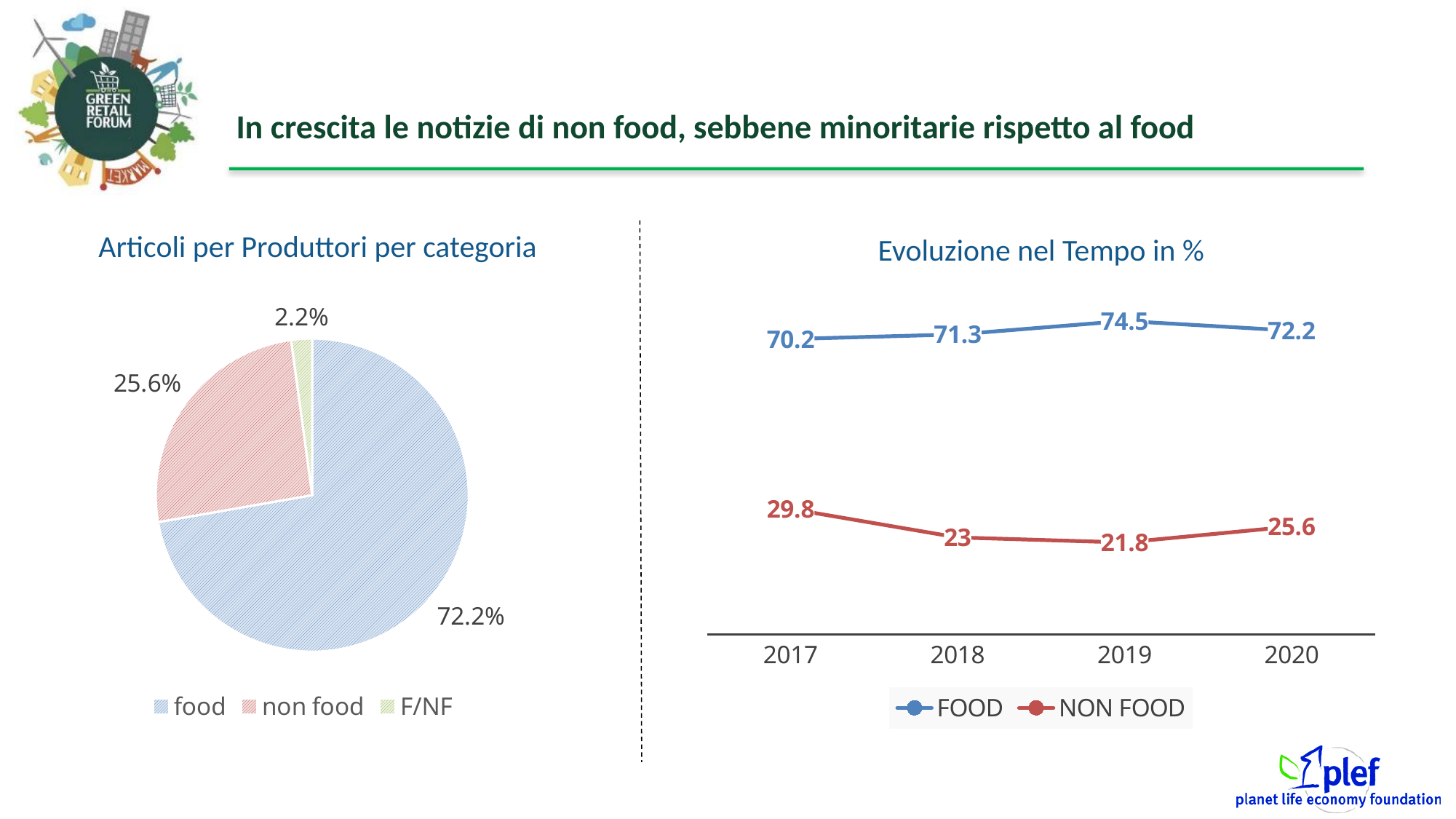
In the pie chart 'Articoli per Produttori per categoria', what share does 'non food' have? 25.6% In the chart 'Evoluzione nel Tempo in %', does the NON FOOD value rise or fall from 2017 to 2018? fall In the pie chart 'Articoli per Produttori per categoria', what share does 'F/NF' have? 2.2% In the chart 'Evoluzione nel Tempo in %', in which year is the NON FOOD value lowest? 2019 What kind of chart is 'Evoluzione nel Tempo in %'? line chart In the chart 'Evoluzione nel Tempo in %', what is the difference between the FOOD and NON FOOD values in 2020? 46.6 How many series does the legend of the chart 'Evoluzione nel Tempo in %' list? 2 How many categories does the pie chart 'Articoli per Produttori per categoria' show? 3 In the chart 'Evoluzione nel Tempo in %', what is the NON FOOD value for 2017? 29.8 In the pie chart 'Articoli per Produttori per categoria', which category has the smallest slice? F/NF In the pie chart 'Articoli per Produttori per categoria', which category has the largest slice? food In the chart 'Evoluzione nel Tempo in %', what is the FOOD value for 2019? 74.5